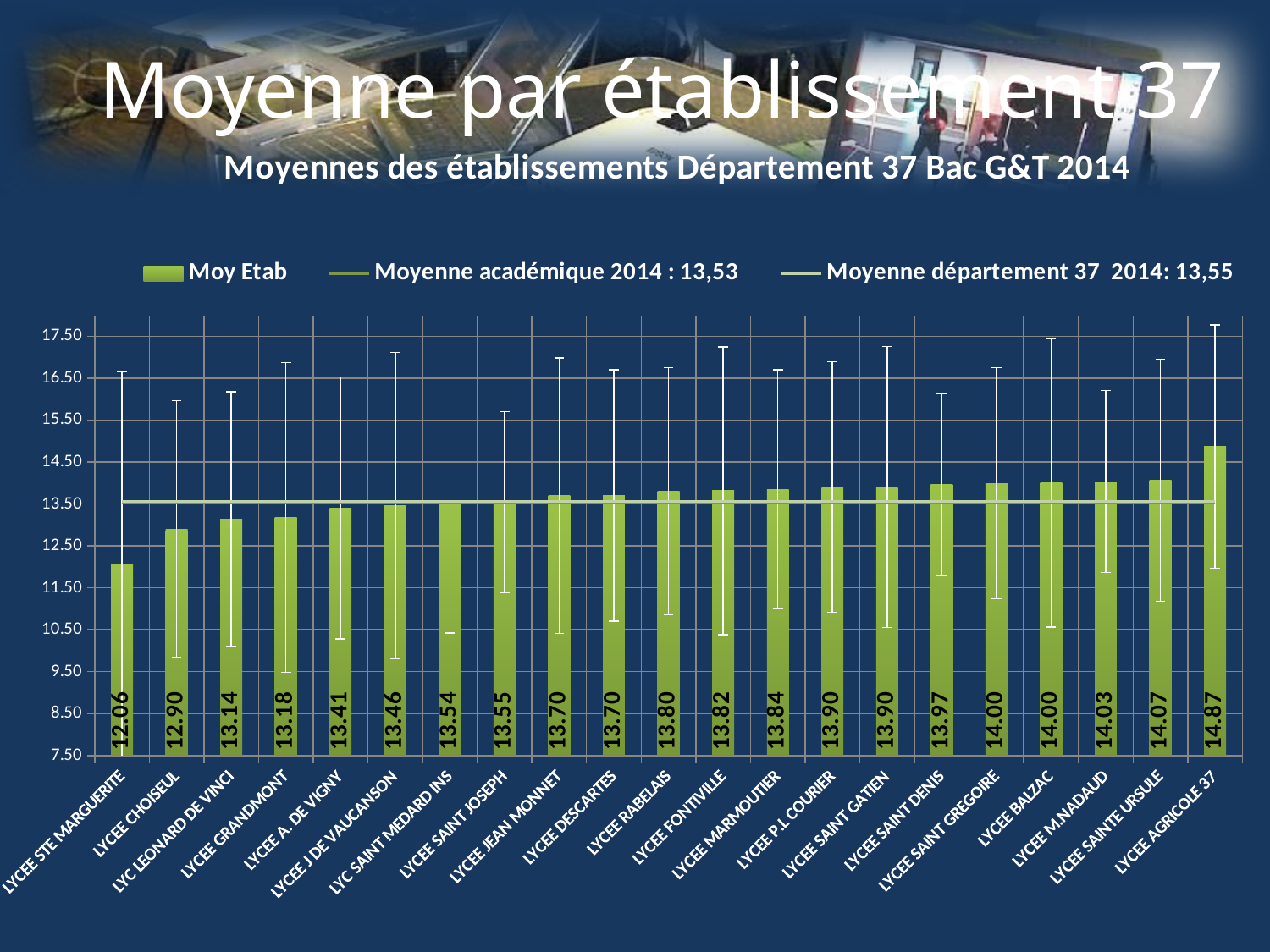
What is the value for LYCEE MARMOUTIER? 13.84 What is the difference between the values for LYCEE AGRICOLE 37 and LYCEE STE MARGUERITE? 2.81 What is the difference between the values for LYCEE CHOISEUL and LYCEE SAINTE URSULE? 1.17 Which establishment has the lowest value? LYCEE STE MARGUERITE What kind of chart is this? Bar chart What is the value for LYCEE AGRICOLE 37? 14.87 How many establishments are shown on the x axis? 21 What is the value for LYCEE GRANDMONT? 13.18 What is the value of the 'Moyenne académique 2014' shown in the legend? 13,53 How many series does the legend list? 3 Which establishment has the highest value? LYCEE AGRICOLE 37 Which has a larger value, LYCEE CHOISEUL or LYCEE RABELAIS? LYCEE RABELAIS